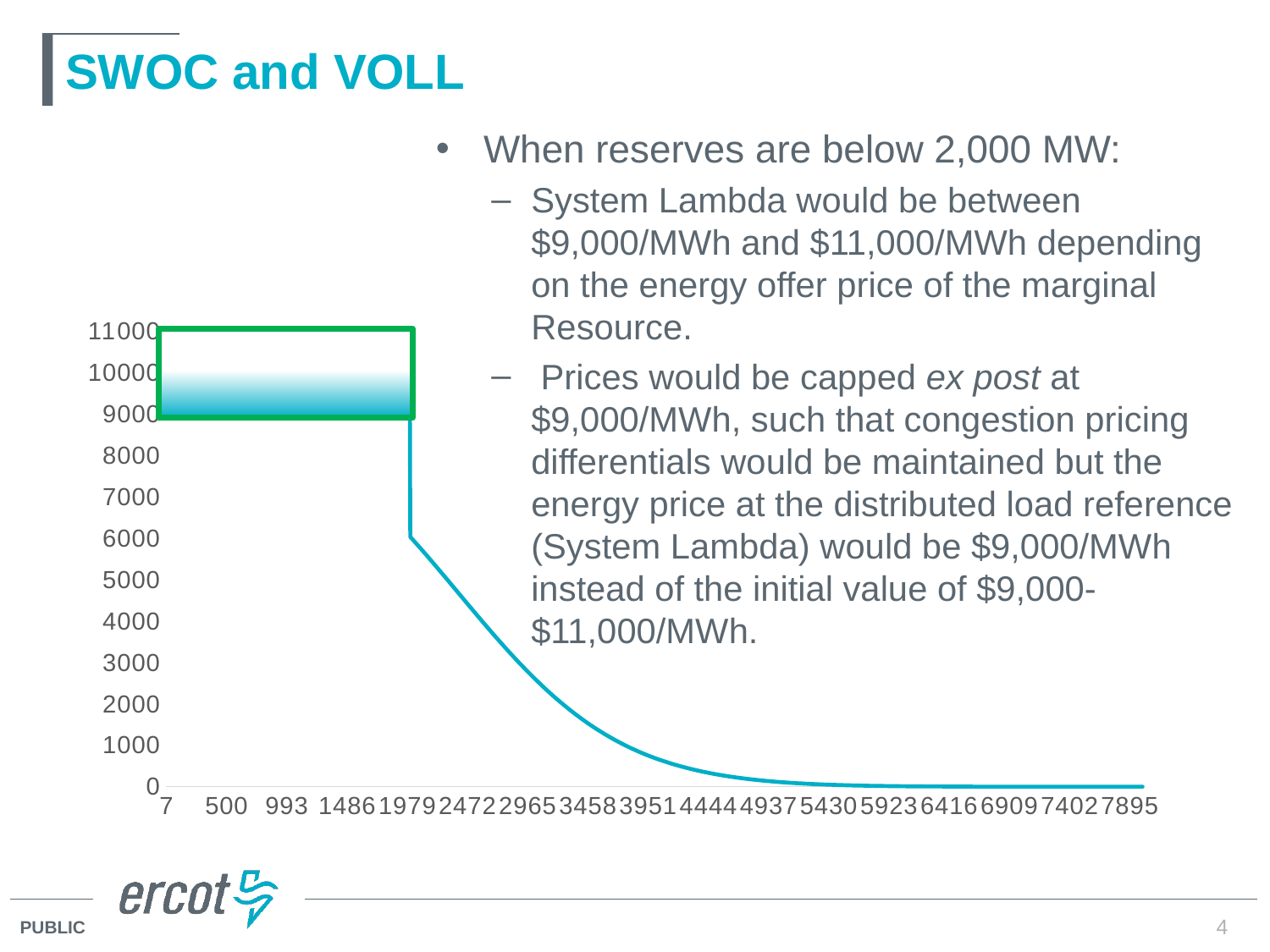
Is the value for 993 greater or less than 7000? greater What kind of chart is shown on the slide? line chart What is the first label on the x axis? 7 How many labels are shown on the x axis of the chart? 17 Do the plotted values rise or fall as you move from left to right along the x axis? fall What is the highest tick value shown on the y axis? 11000 Is the value for 2472 greater or less than 2000? greater Is the value for 500 greater or less than 8000? greater Is the value for 500 larger or smaller than the value for 3458? larger